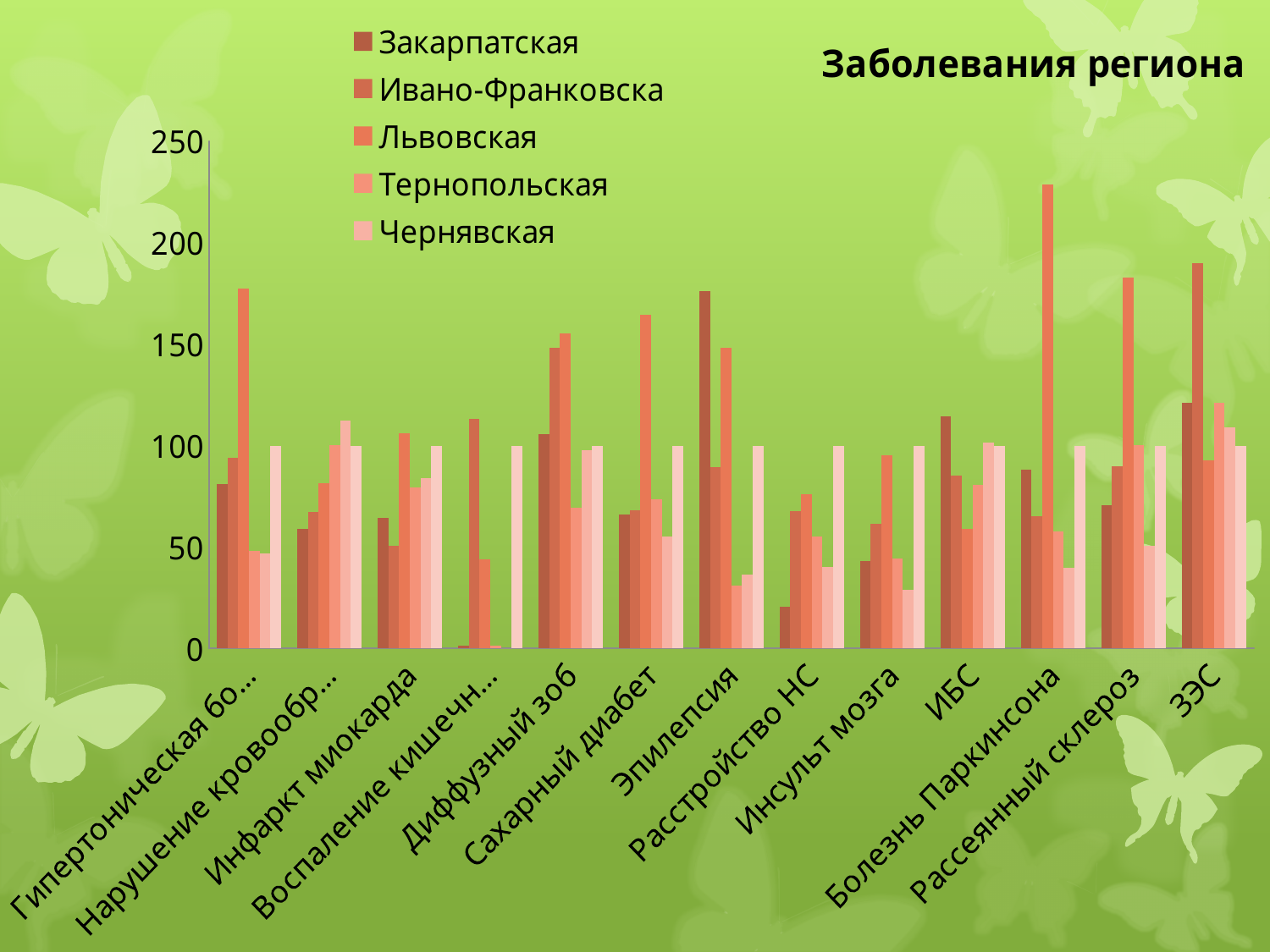
Is the value for Ивано-Франковска in the Болезнь Паркинсона category greater or less than 200? less What type of chart is shown on the slide? bar chart Which series has the highest value in the Эпилепсия category? Закарпатская How many series does the legend list? 5 What is the title of the chart? Заболевания региона How many disease categories are shown on the x axis? 13 Is the value for Закарпатская in the Расстройство НС category greater or less than 50? less Is the value for Львовская in the Гипертоническая category greater or less than 150? greater For Ивано-Франковска, which is larger: the value for Рассеянный склероз or the value for ИБС? Рассеянный склероз In which category does Ивано-Франковска have its highest value? ЗЭС